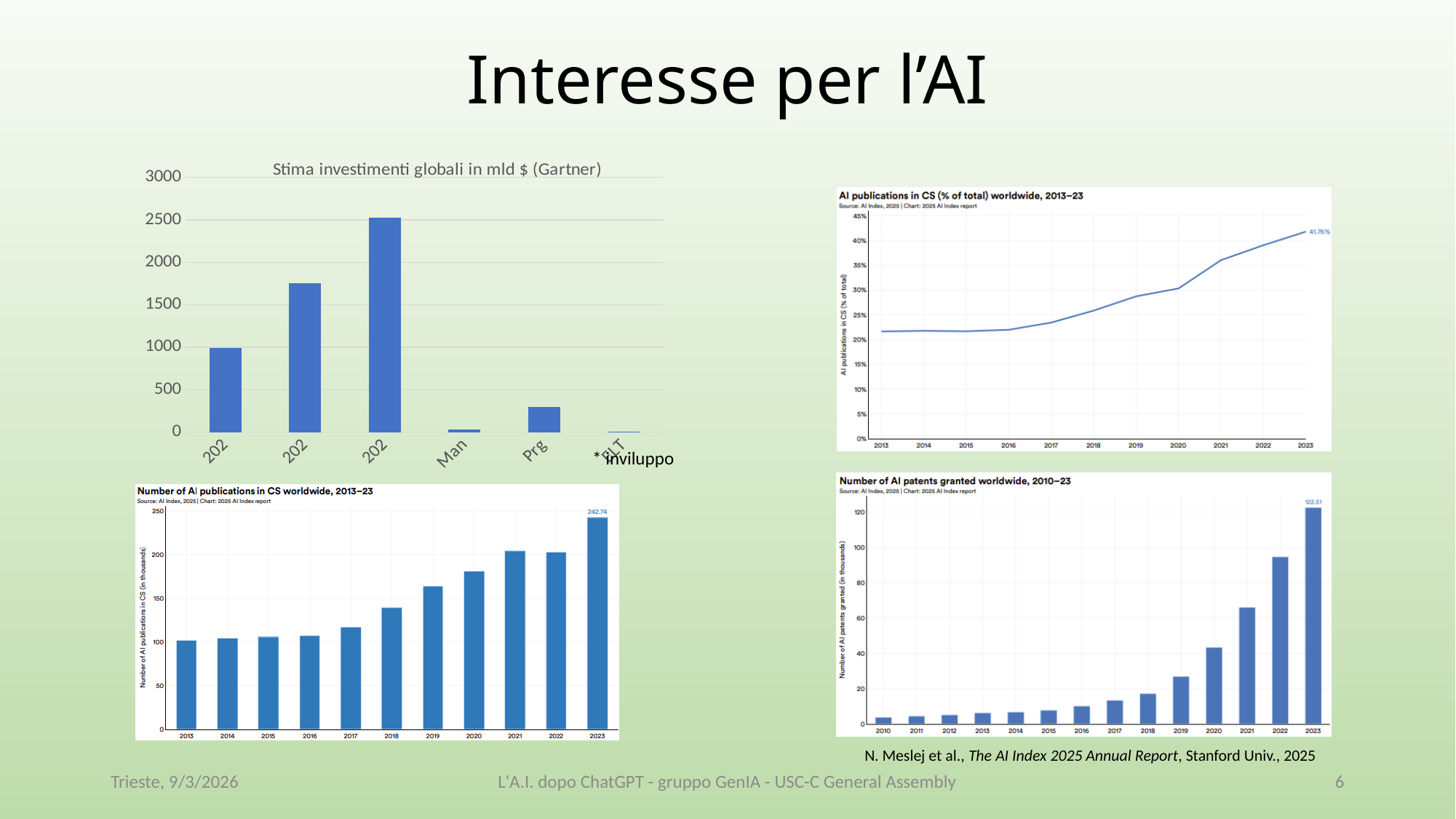
In the chart 'AI publications in CS (% of total) worldwide, 2013–23', does the line rise or fall from 2013 to 2023? rise In the chart 'Number of AI patents granted worldwide, 2010–23', is the value for 2022 greater or less than 80? greater In the chart 'Number of AI patents granted worldwide, 2010–23', what value is labelled for 2023? 122.51 In the chart 'Number of AI patents granted worldwide, 2010–23', which year has the highest bar? 2023 What kind of chart is 'AI publications in CS (% of total) worldwide, 2013–23'? line chart How many bars are shown in the chart 'Number of AI publications in CS worldwide, 2013–23'? 11 What kind of chart is 'Stima investimenti globali in mld $ (Gartner)'? bar chart In the chart 'Number of AI publications in CS worldwide, 2013–23', what value is labelled for 2023? 242.74 In the chart 'AI publications in CS (% of total) worldwide, 2013–23', what value is labelled for 2023? 41.76% In the chart 'Number of AI publications in CS worldwide, 2013–23', which year has the lowest bar? 2013 In the chart 'Stima investimenti globali in mld $ (Gartner)', which is larger, the value for Man or the value for Prg? Prg How many bars are shown in the chart 'Number of AI patents granted worldwide, 2010–23'? 14